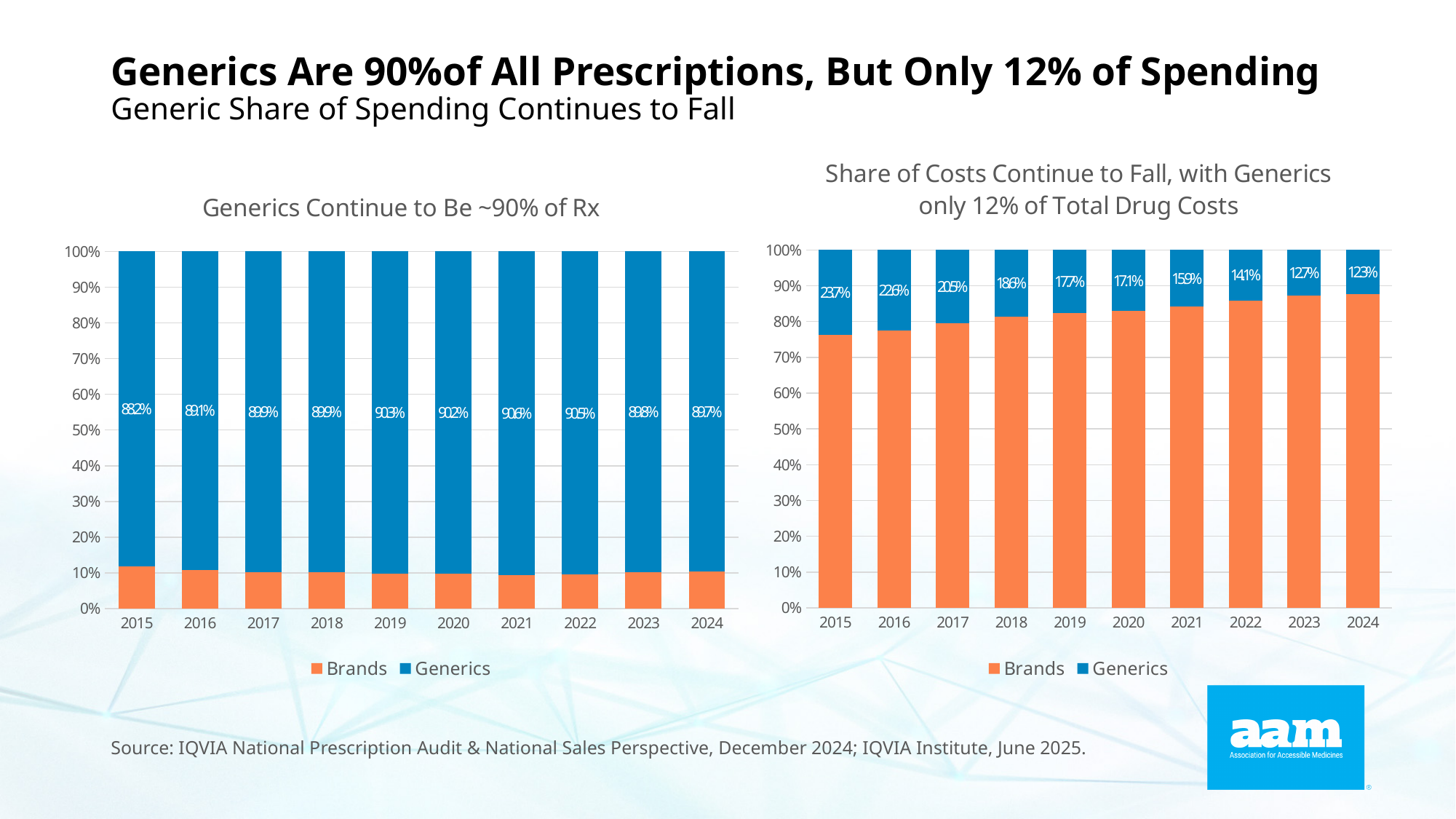
In the left chart (Generics Continue to Be ~90% of Rx), what is the Generics share in 2015? 88.2% In the right chart (Share of Costs Continue to Fall), is the Brands share of costs in 2024 greater or less than 80%? greater In the right chart (Share of Costs Continue to Fall), does the Generics share of costs rise or fall from 2015 to 2024? fall In the right chart (Share of Costs Continue to Fall), what is the Generics share of costs in 2024? 12.3% In the left chart (Generics Continue to Be ~90% of Rx), which year has the lowest Generics share? 2015 In the left chart (Generics Continue to Be ~90% of Rx), what is the Generics share in 2021? 90.6% In the right chart (Share of Costs Continue to Fall), which year has the highest Generics share of costs? 2015 In the right chart (Share of Costs Continue to Fall), is the Generics share of costs larger in 2017 or in 2022? 2017 In the right chart (Share of Costs Continue to Fall), what is the Generics share of costs in 2018? 18.6% How many series does the legend of the right chart (Share of Costs Continue to Fall) list? 2 In the right chart (Share of Costs Continue to Fall), by how many percentage points did the Generics share of costs fall from 2015 to 2024? 11.4 percentage points How many years are shown on the x axis of the left chart (Generics Continue to Be ~90% of Rx)? 10